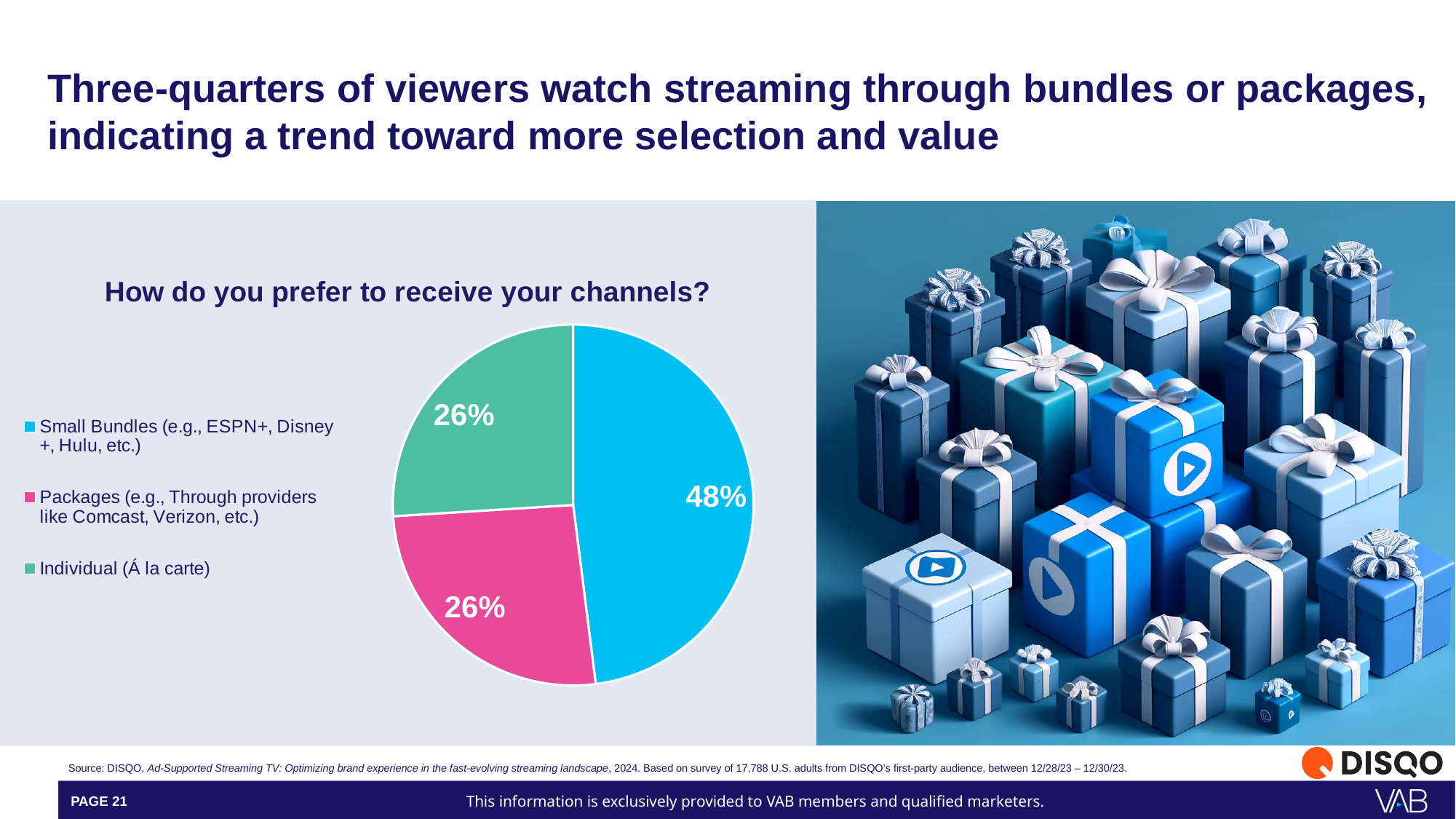
What is the combined share of Small Bundles and Packages? 74% What share of viewers prefer Individual (Á la carte)? 26% What share of viewers prefer Small Bundles (e.g., ESPN+, Disney+, Hulu, etc.)? 48% What is the chart's title? How do you prefer to receive your channels? Which is larger, the share for Small Bundles or the share for Individual (Á la carte)? Small Bundles What share of viewers prefer Packages (e.g., Through providers like Comcast, Verizon, etc.)? 26% How many slices does the pie chart have? 3 How many entries does the legend list? 3 What colour is the Packages slice in the pie chart? pink What kind of chart is shown on the slide? pie chart What is the difference in percentage points between Small Bundles and Packages? 22 Which option has the largest share of the pie? Small Bundles (e.g., ESPN+, Disney+, Hulu, etc.)